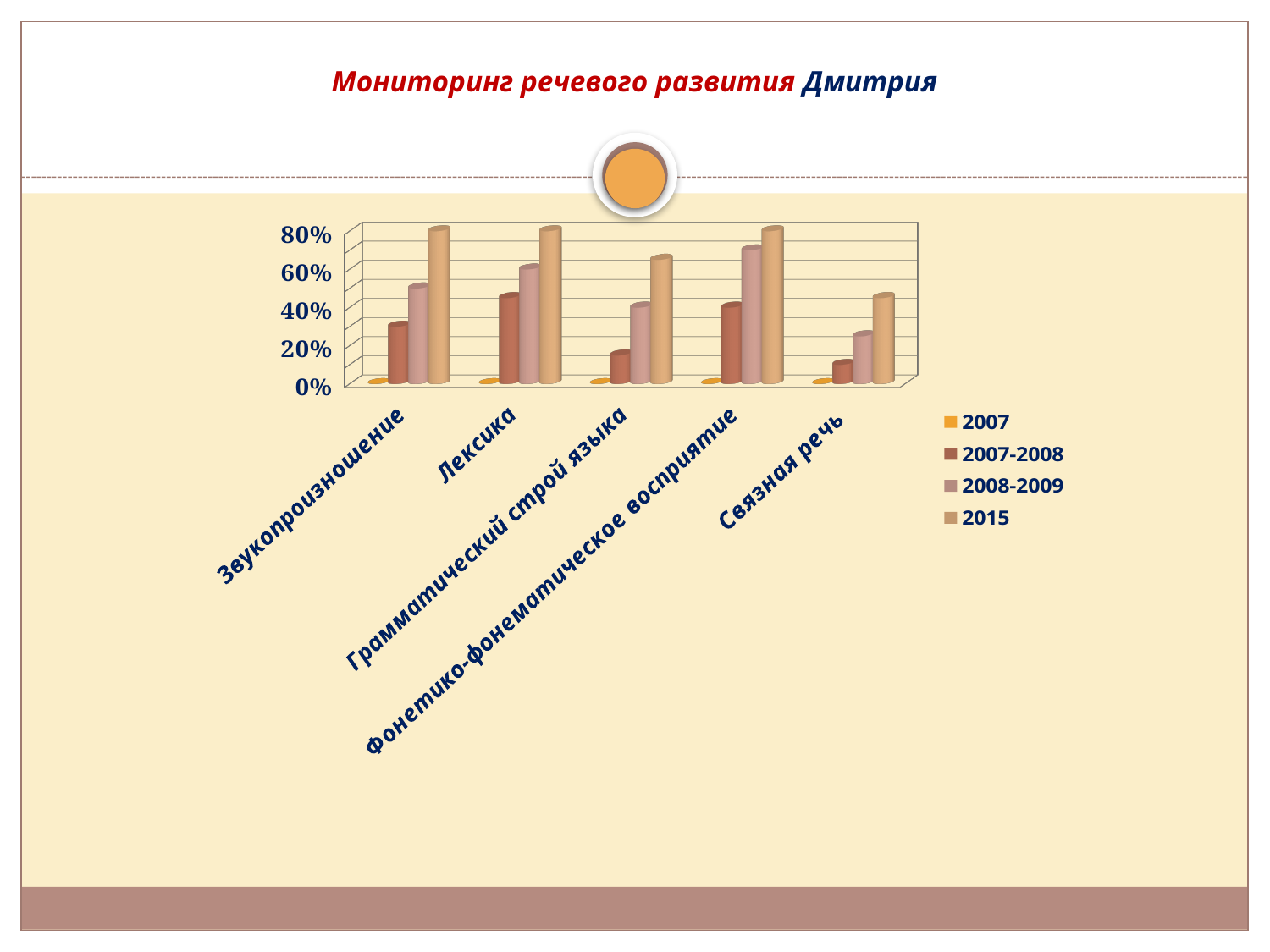
What kind of chart is shown on the slide? Bar chart Among the 2015 bars, which category has the lowest value? Связная речь Is the 2008-2009 value for Фонетико-фонематическое восприятие greater or less than 60%? greater For Лексика, which is larger: the 2007-2008 value or the 2015 value? 2015 How many categories are shown on the x axis of the chart? 5 Is the 2015 value for Связная речь greater or less than 60%? less What is the title of the slide containing the chart? Мониторинг речевого развития Дмитрия Is the 2007-2008 value for Грамматический строй языка greater or less than 40%? less Which series has the lowest bar in every category? 2007 How many series does the chart legend list? 4 Which series has the highest bar in every category? 2015